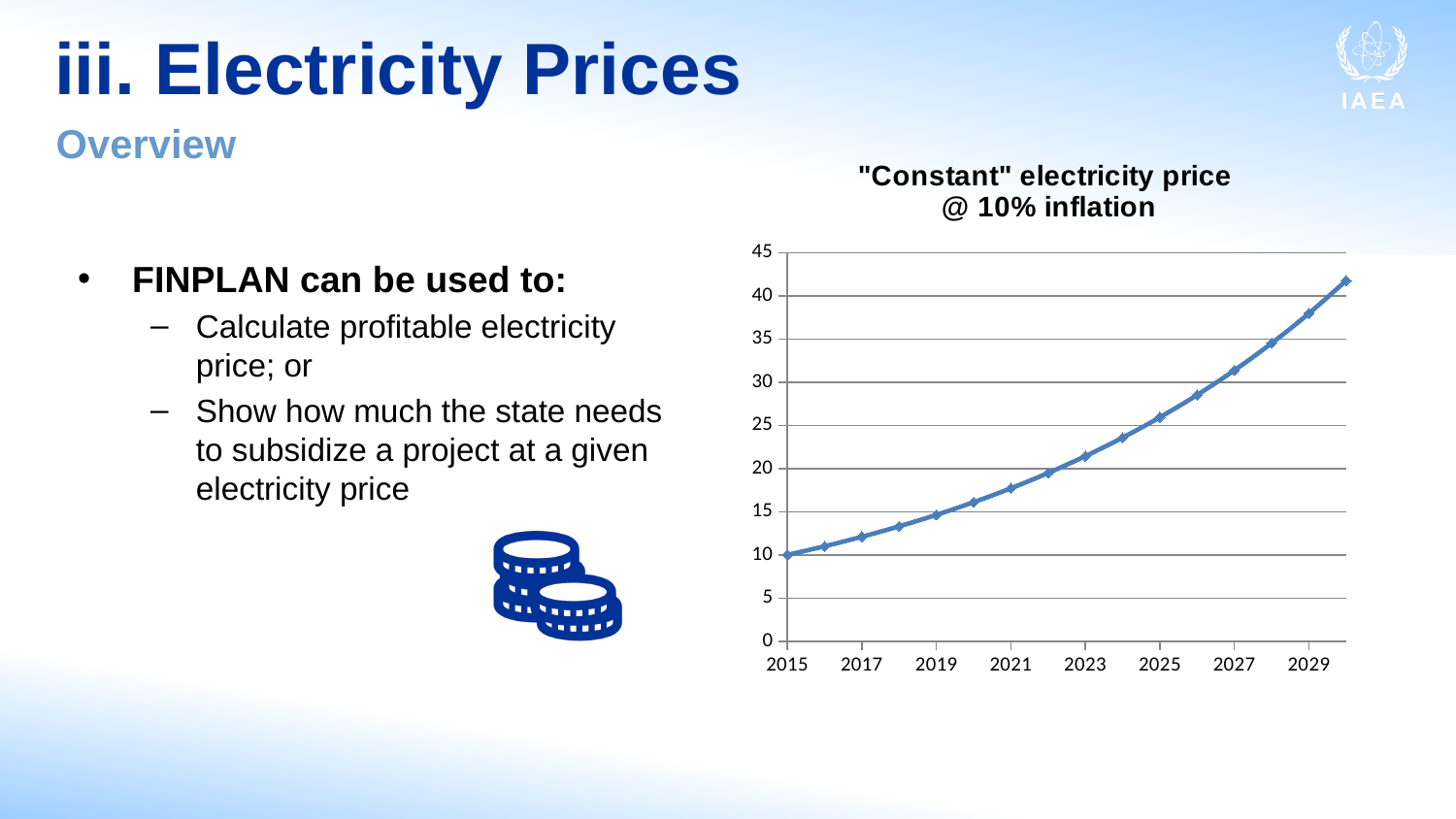
Do the values rise or fall from 2015 to 2030? rise Is the value for 2023 greater or less than 20? greater Which year has the lowest electricity price? 2015 Is the value for 2029 greater or less than 40? less What is the value of the electricity price in 2015? 10 What is the title of the chart? "Constant" electricity price @ 10% inflation Is the value for 2030 greater or less than 40? greater What inflation rate is stated in the chart title? 10% Which year has the highest electricity price? 2030 Which is larger, the value for 2025 or the value for 2020? 2025 What kind of chart is shown on the slide? line chart